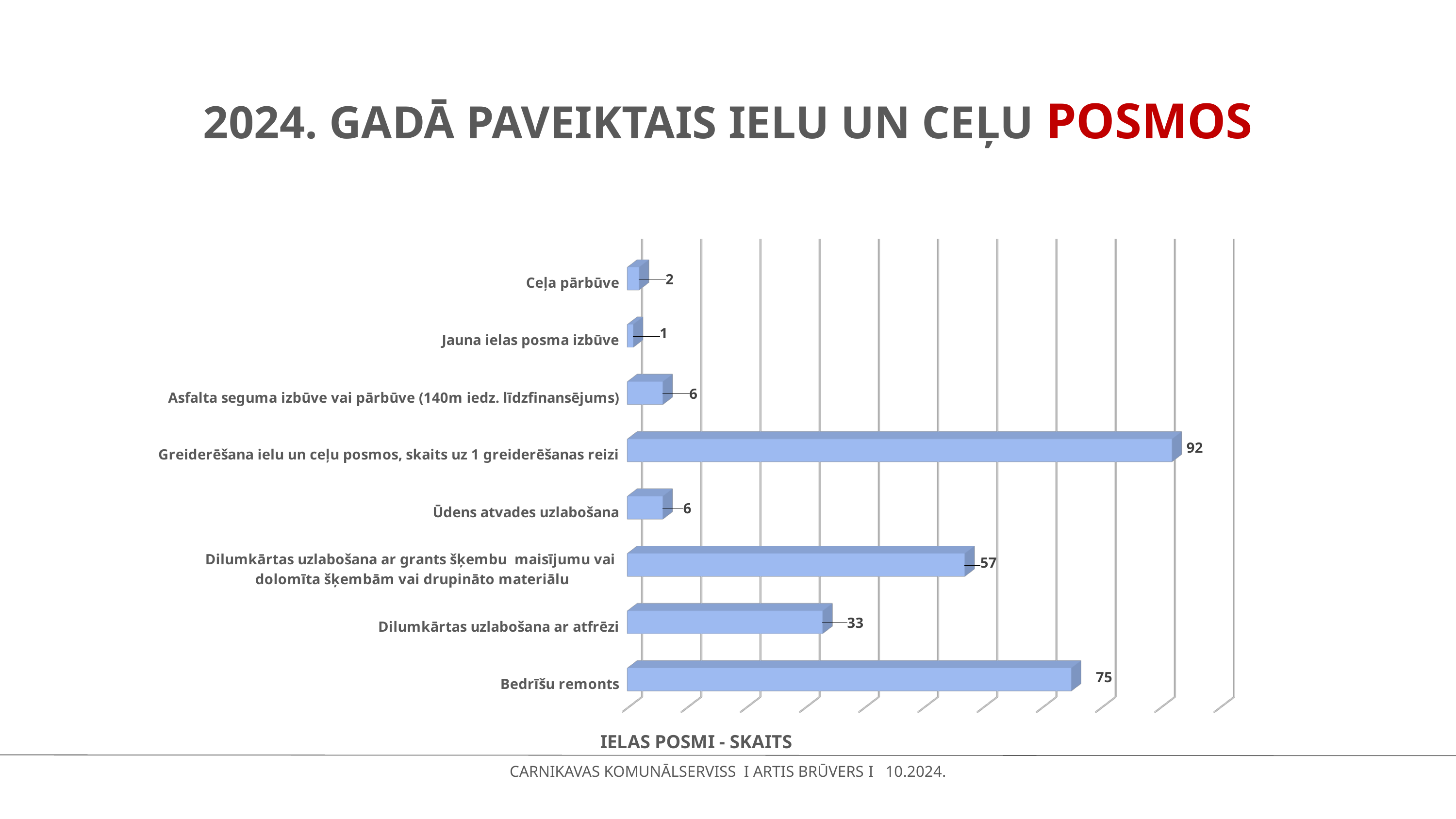
What is the value for Jauna ielas posma izbūve? 1 How many categories are shown in the chart? 8 Which category has the highest value? Greiderēšana ielu un ceļu posmos, skaits uz 1 greiderēšanas reizi What is the value for Greiderēšana ielu un ceļu posmos, skaits uz 1 greiderēšanas reizi? 92 What is the value for Bedrīšu remonts? 75 What is the value for Dilumkārtas uzlabošana ar atfrēzi? 33 Which is larger: the value for Bedrīšu remonts or the value for Dilumkārtas uzlabošana ar grants šķembu maisījumu vai dolomīta šķembām vai drupināto materiālu? Bedrīšu remonts What is the difference between the values for Bedrīšu remonts and Dilumkārtas uzlabošana ar atfrēzi? 42 What is the value for Ūdens atvades uzlabošana? 6 What kind of chart is shown on the slide? Bar chart Which category has the lowest value? Jauna ielas posma izbūve What is the title shown below the chart? IELAS POSMI - SKAITS